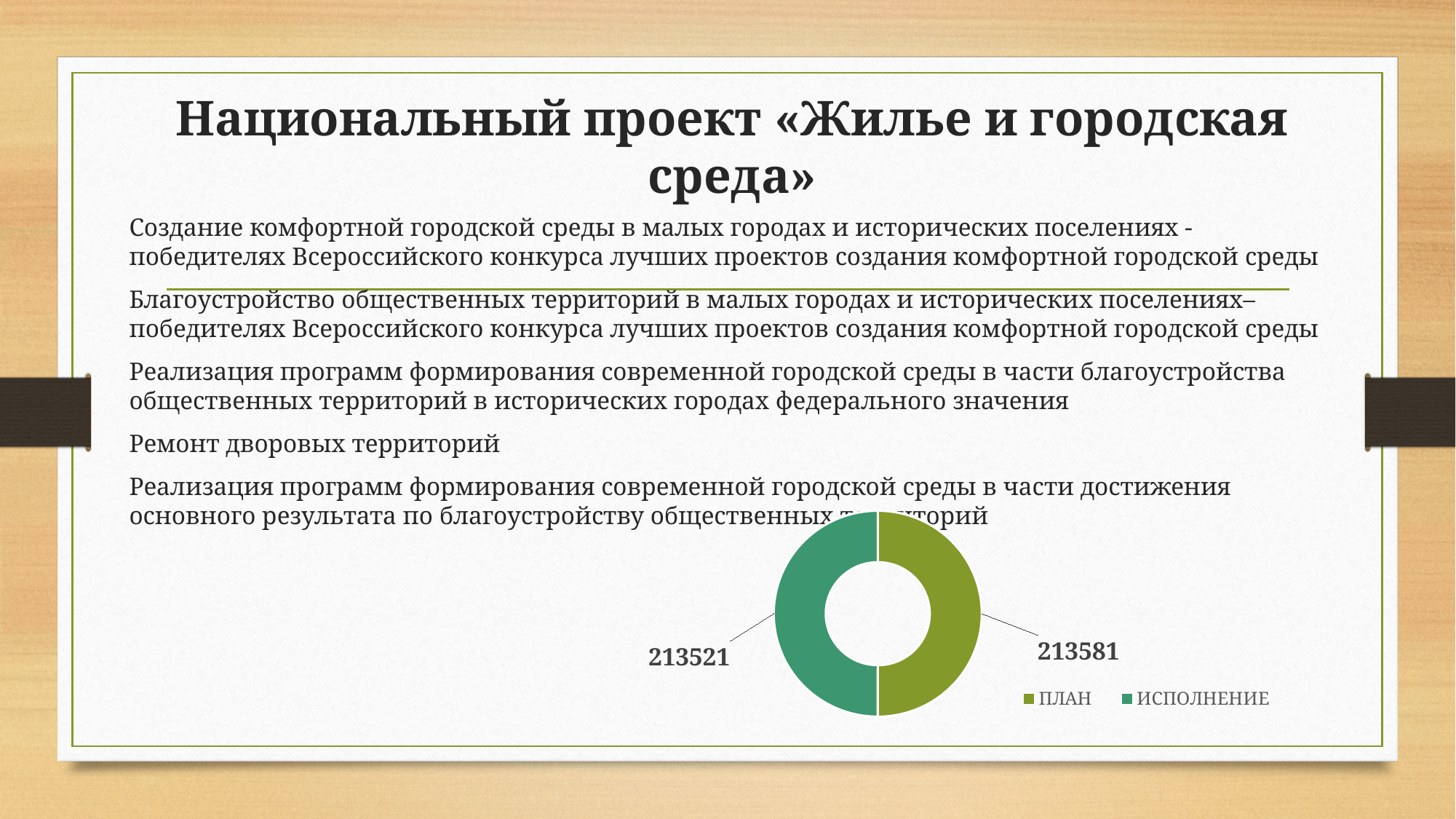
What is the value for ПЛАН in the doughnut chart? 213581 How many series does the chart legend list? 2 What is the difference between the ПЛАН and ИСПОЛНЕНИЕ values? 60 What kind of chart is shown on the slide? doughnut chart Which legend entry is shown in the teal (green-blue) colour? ИСПОЛНЕНИЕ What is the value for ИСПОЛНЕНИЕ in the doughnut chart? 213521 According to the data labels, which is larger: ПЛАН or ИСПОЛНЕНИЕ? ПЛАН What is the total of the two values shown in the doughnut chart? 427102 Which legend entry is shown in the olive green colour? ПЛАН How many slices does the doughnut chart have? 2